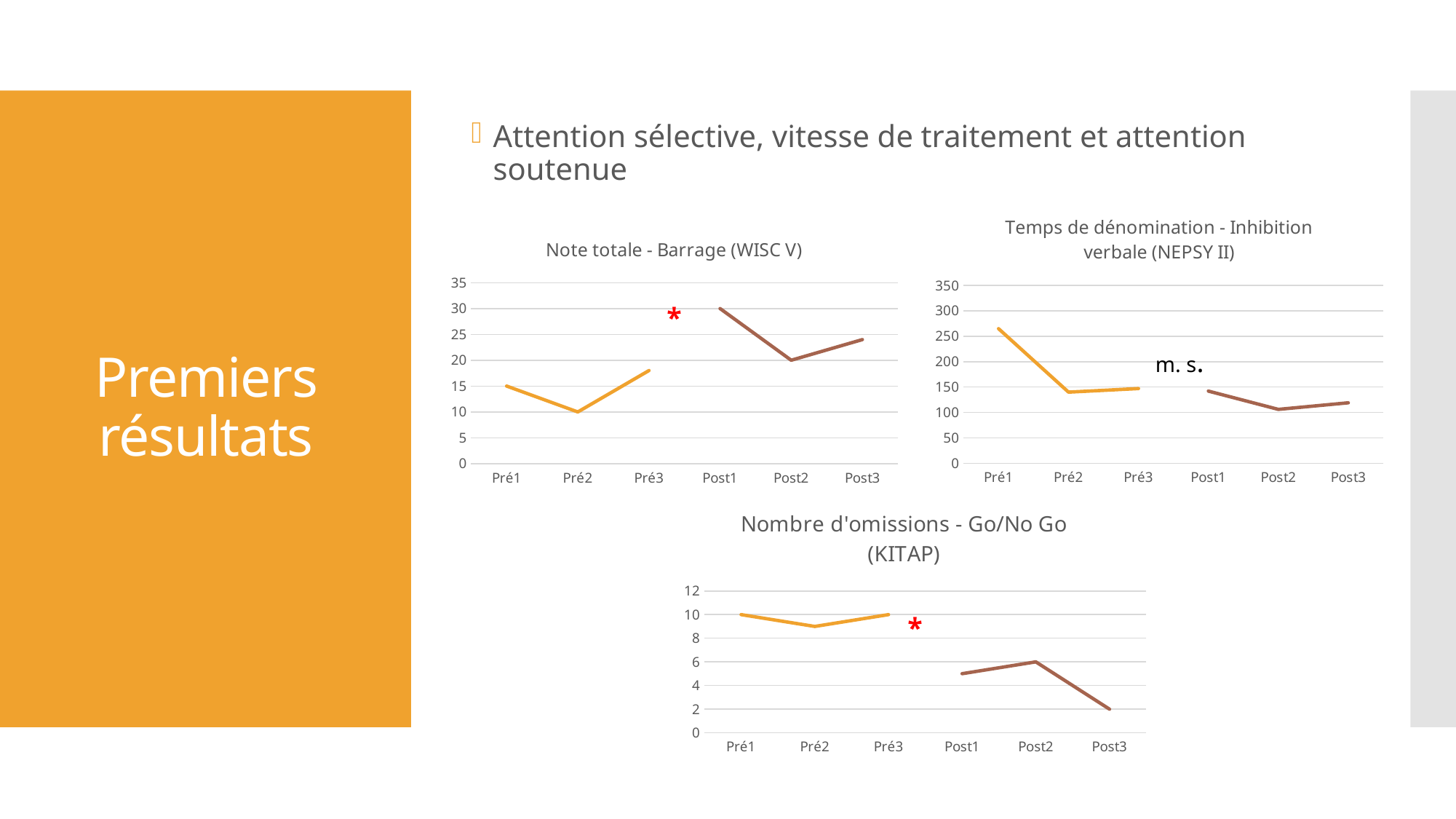
In the 'Nombre d'omissions - Go/No Go (KITAP)' chart, do the values rise or fall from Post2 to Post3? fall How many points are plotted along the x axis of the 'Nombre d'omissions - Go/No Go (KITAP)' chart? 6 In the 'Note totale - Barrage (WISC V)' chart, what is the value at Pré2? 10 In the 'Nombre d'omissions - Go/No Go (KITAP)' chart, what is the value at Post3? 2 In the 'Temps de dénomination - Inhibition verbale (NEPSY II)' chart, is the value for Pré1 greater or less than 250? greater In the 'Note totale - Barrage (WISC V)' chart, which point has the lowest value? Pré2 In the 'Temps de dénomination - Inhibition verbale (NEPSY II)' chart, which point has the highest value? Pré1 In the 'Note totale - Barrage (WISC V)' chart, which point has the highest value? Post1 In the 'Nombre d'omissions - Go/No Go (KITAP)' chart, is the value for Pré1 larger than the value for Post1? yes What kind of chart is the 'Note totale - Barrage (WISC V)' chart? line chart In the 'Temps de dénomination - Inhibition verbale (NEPSY II)' chart, which point has the lowest value? Post2 In the 'Note totale - Barrage (WISC V)' chart, what is the value at Post1? 30